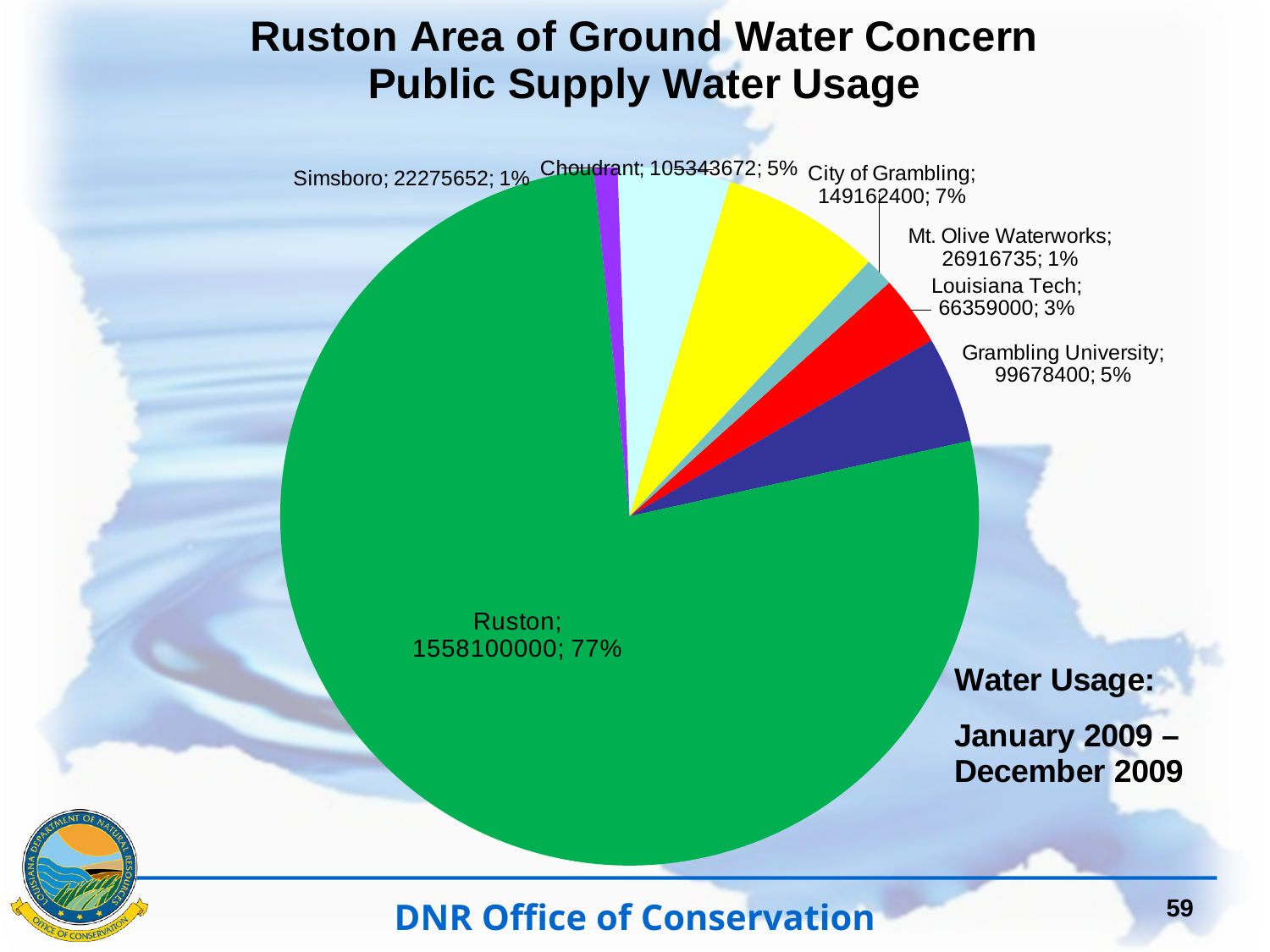
Which category has the largest slice of the pie? Ruston What is the difference between the water usage values for City of Grambling and Grambling University? 49484000 How many categories (slices) are shown in the pie chart? 7 What is the water usage value for Ruston? 1558100000 What is the water usage value for Mt. Olive Waterworks? 26916735 What is the water usage value for City of Grambling? 149162400 Which category has the smallest water usage value? Simsboro Which has a larger water usage value, Choudrant or Grambling University? Choudrant What is the water usage value for Louisiana Tech? 66359000 What kind of chart is shown on the slide? pie chart What percentage share of the pie does Ruston have? 77% What percentage share of the pie does City of Grambling have? 7%